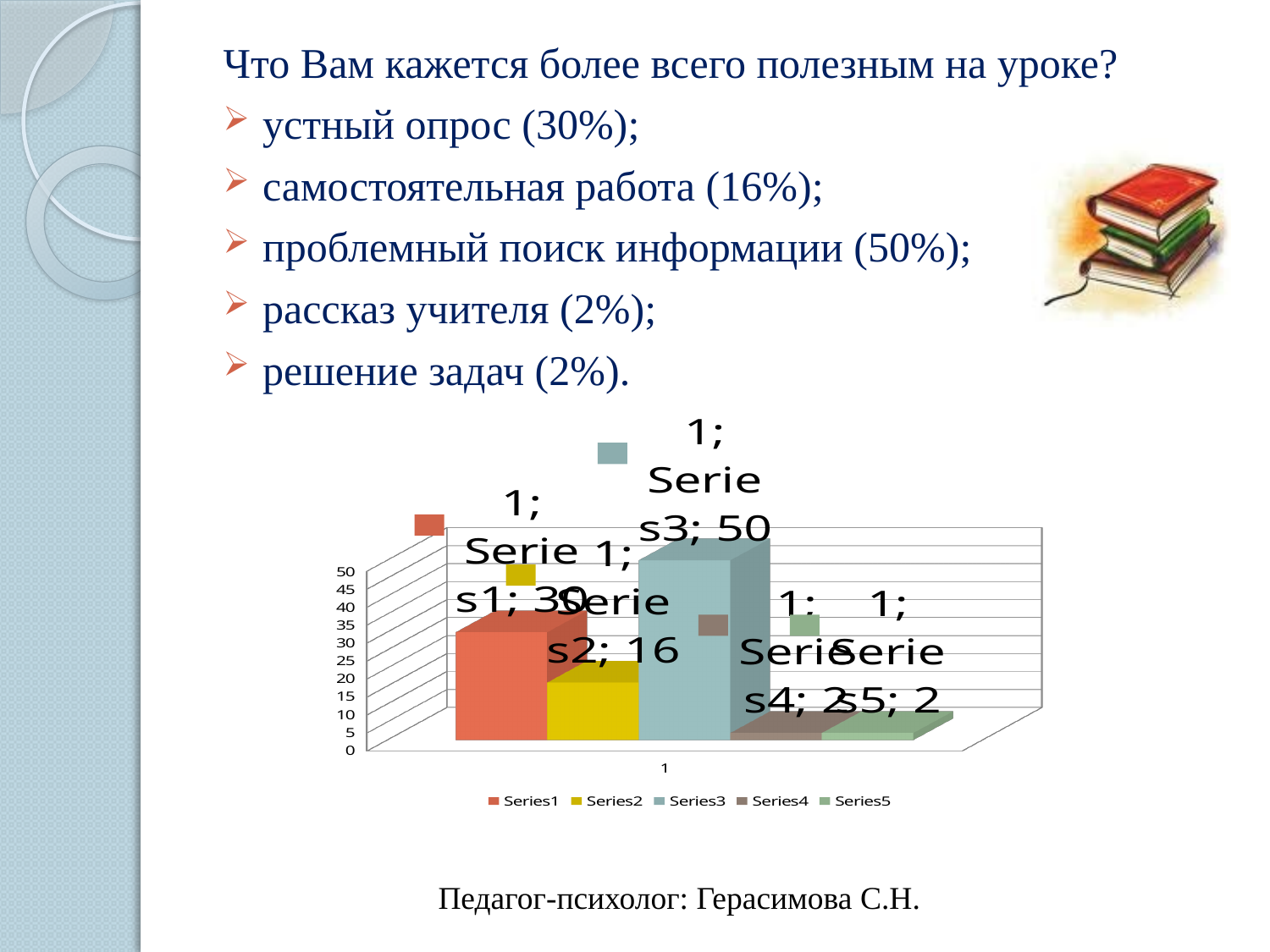
Is the value for Series3 greater or less than 40? greater What is the value for Series4 in the chart? 2 Which is larger, the value for Series1 or the value for Series2? Series1 What is the category label shown on the x axis of the chart? 1 What kind of chart is shown on the slide? bar chart What is the value for Series2 in the chart? 16 Which series has the highest value in the chart? Series3 What is the value for Series1 in the chart? 30 What is the difference between the values for Series3 and Series1? 20 What is the value for Series3 in the chart? 50 How many series does the legend list? 5 What is the difference between the values for Series1 and Series2? 14